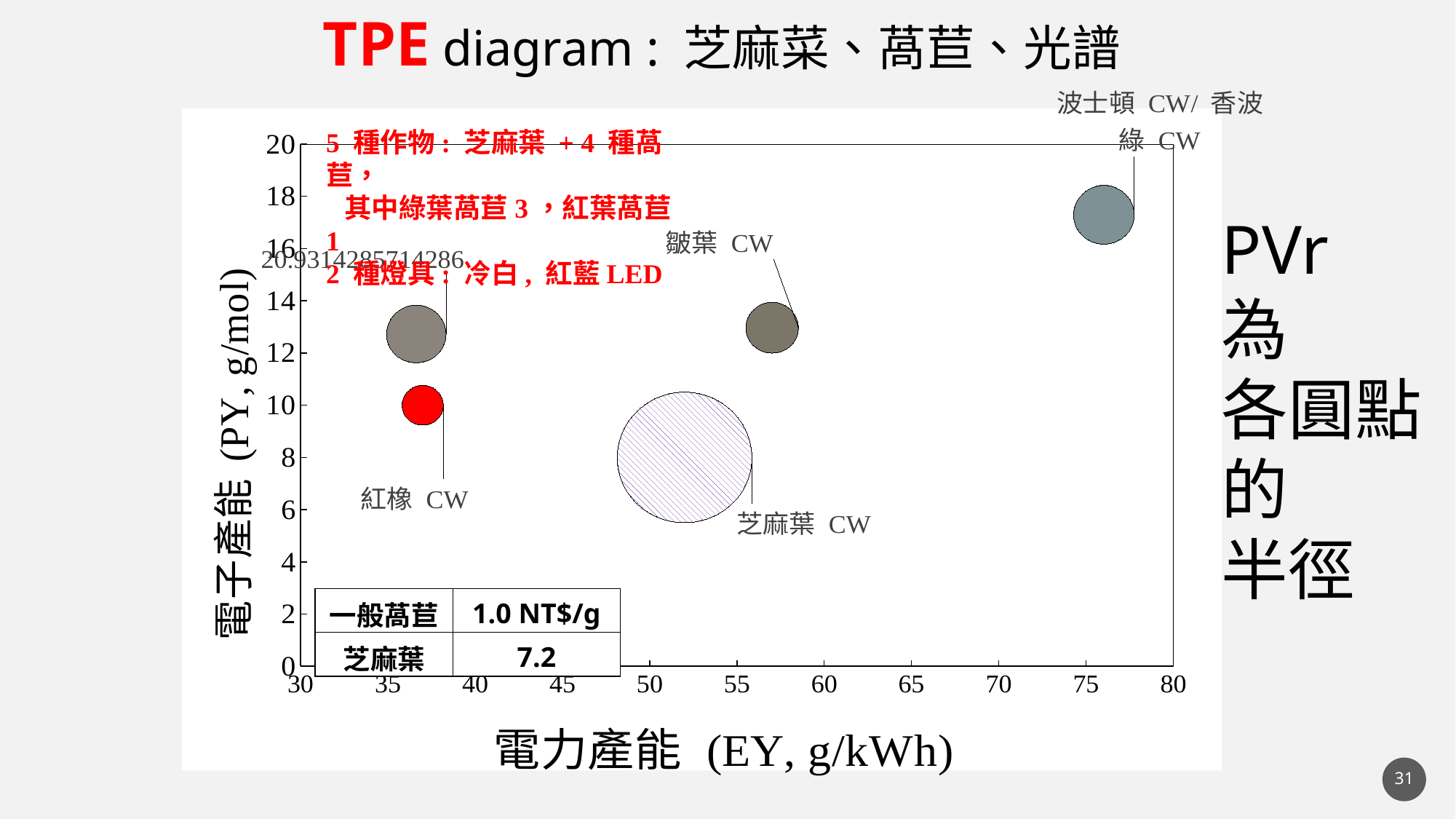
Which labelled bubble has the lowest value on the y axis (電子產能, PY)? 芝麻葉 CW Is the y-axis value (PY) for 芝麻葉 CW greater or less than 10? less Is the x-axis value (EY) for 紅橡 CW greater or less than 40? less Is the x-axis value (EY) for 皺葉 CW greater or less than 50? greater Which bubble is drawn in red? 紅橡 CW Which has the higher y-axis value (PY): 皺葉 CW or 紅橡 CW? 皺葉 CW What kind of chart is shown on the slide? bubble chart What is the title of the x axis? 電力產能 (EY, g/kWh) Which bubble has the highest value on the x axis (電力產能, EY)? 波士頓 CW/ 香波綠 CW How many bubbles are plotted on the chart? 5